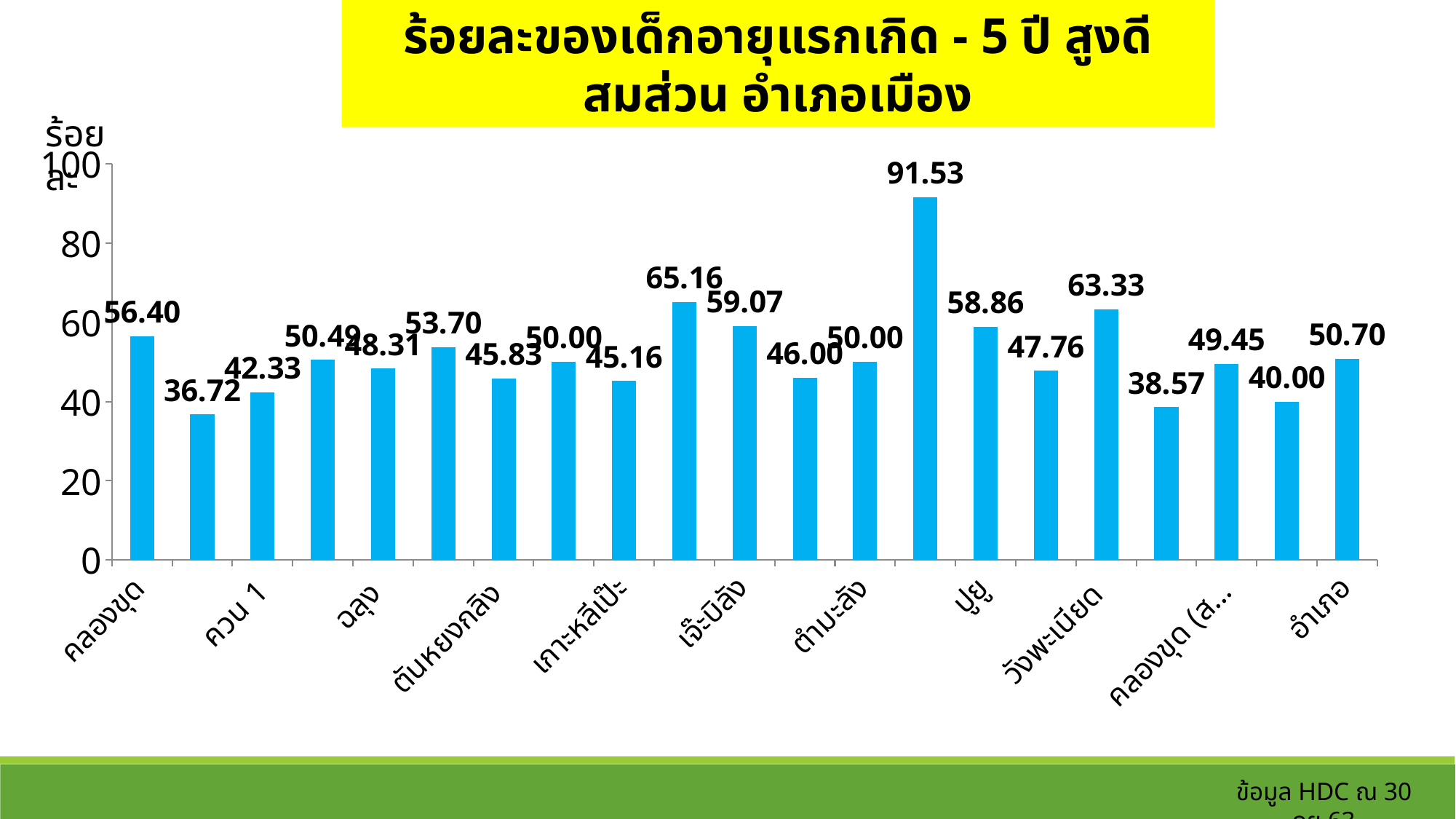
What is the value for อำเภอ? 50.70 Which has a larger value, วังพะเนียด or ปูยู? วังพะเนียด How many bars are plotted on the chart? 21 What is the value for วังพะเนียด? 63.33 What is the difference between the values for คลองขุด and ควน 1? 14.07 What kind of chart is shown on the slide? bar chart What is the value for คลองขุด? 56.40 What is the value for เจ๊ะบิลัง? 59.07 What is the lowest value shown on the chart? 36.72 What is the highest value shown on the chart? 91.53 Is the value for ตันหยงกลิง greater or less than 60? less What is the maximum value shown on the vertical axis? 100